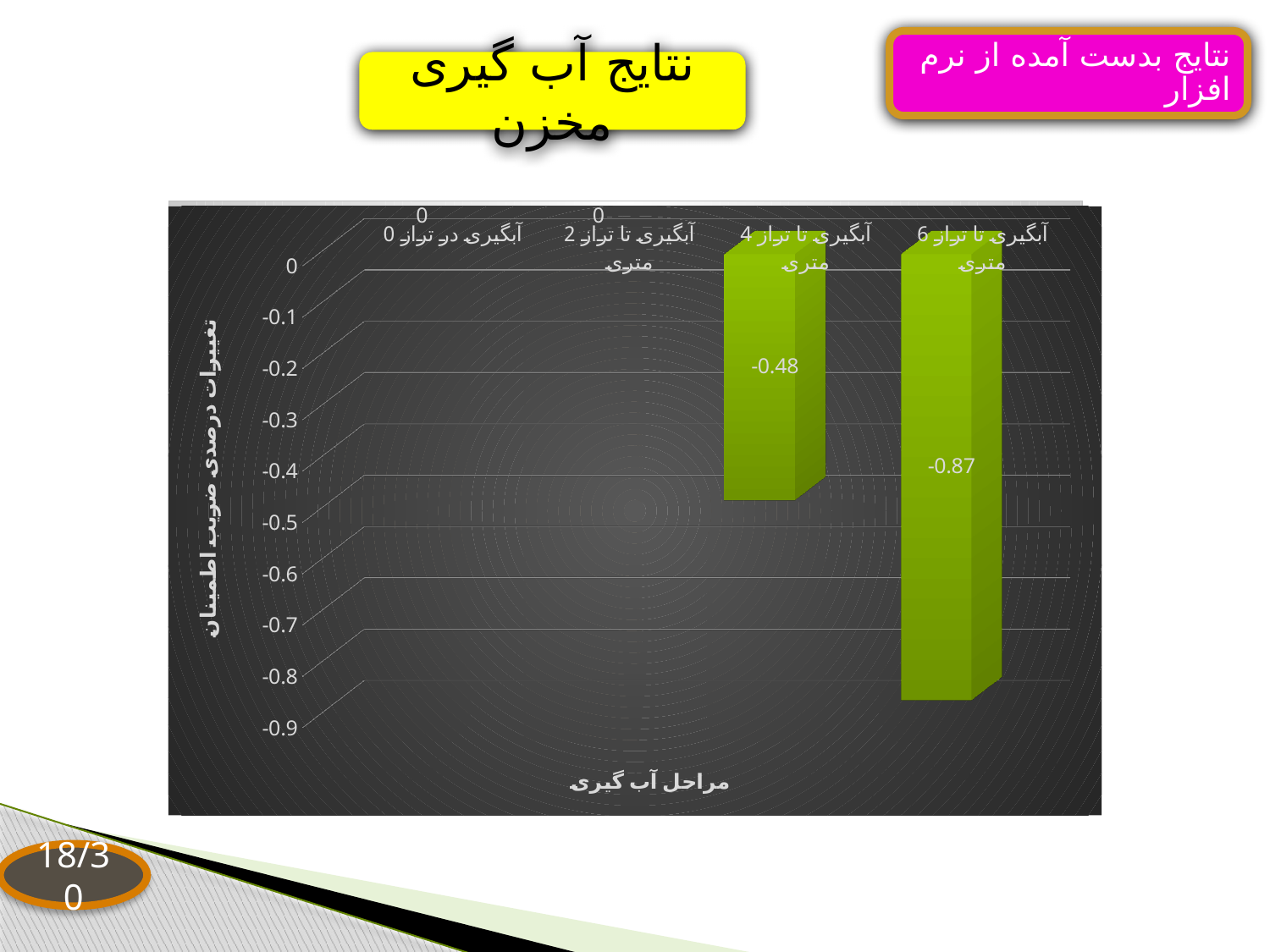
What is the value for "آبگیری تا تراز 2 متری"? 0 Which is larger, the value for "آبگیری تا تراز 4 متری" or the value for "آبگیری تا تراز 6 متری"? آبگیری تا تراز 4 متری What is the title of the x axis? مراحل آب گیری What is the value for "آبگیری در تراز 0"? 0 How many categories are shown on the x axis? 4 Which category has the lowest value? آبگیری تا تراز 6 متری What is the value for "آبگیری تا تراز 6 متری"? -0.87 Is the value for "آبگیری تا تراز 4 متری" greater or less than -0.4? less What is the difference between the values for "آبگیری تا تراز 4 متری" and "آبگیری تا تراز 6 متری"? 0.39 What kind of chart is shown on the slide? bar chart Is the value for "آبگیری تا تراز 6 متری" greater or less than -0.8? less What is the value for "آبگیری تا تراز 4 متری"? -0.48